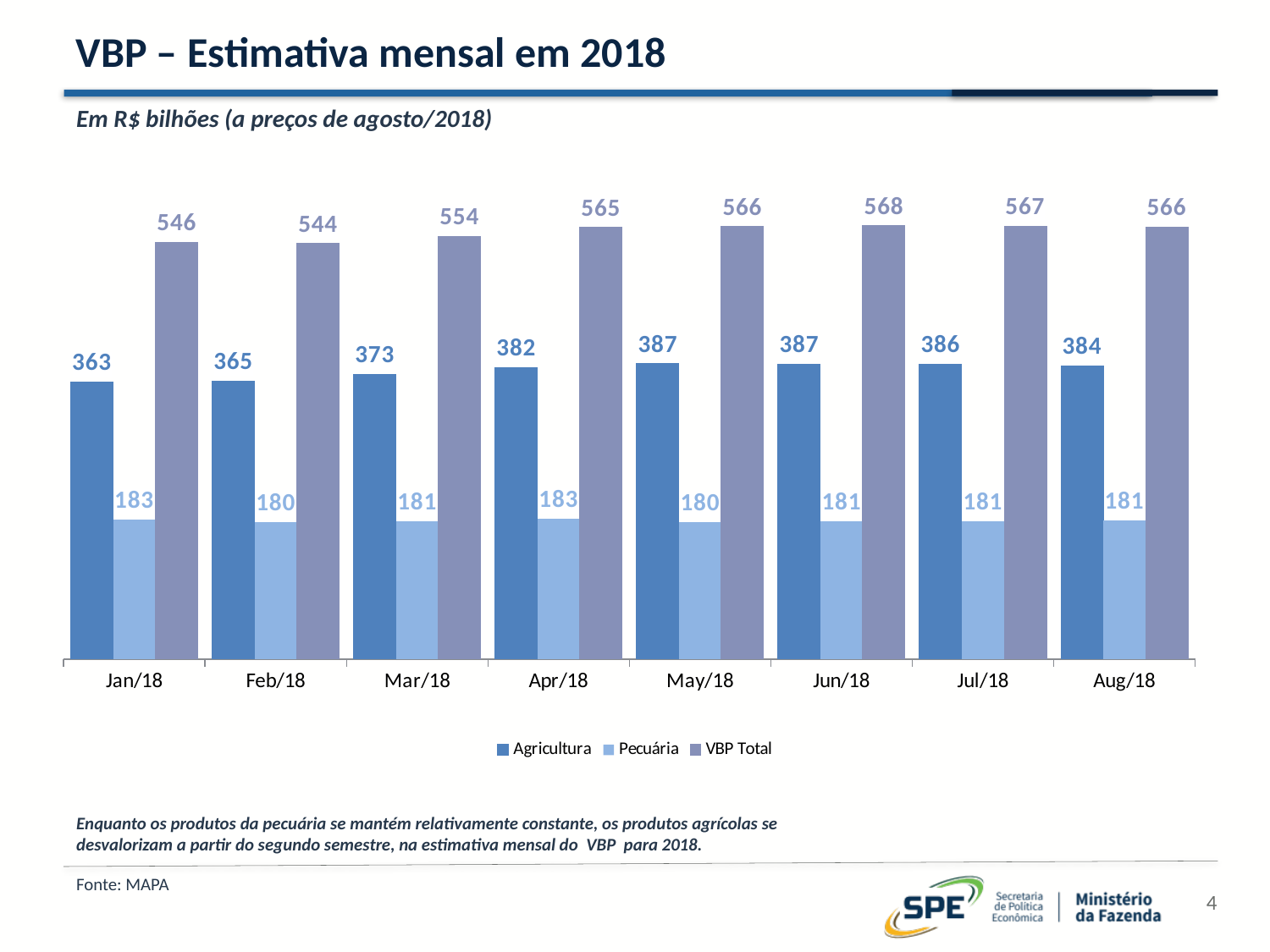
In which month is VBP Total highest? Jun/18 In which month is VBP Total lowest? Feb/18 What is the unit stated in the chart subtitle? R$ bilhões (a preços de agosto/2018) What kind of chart is shown on the slide? bar chart Which is larger, the Agricultura value for Mar/18 or for Aug/18? Aug/18 What is the Pecuária value for Feb/18? 180 What is the difference between the Agricultura values for May/18 and Jan/18? 24 How many months are shown on the x axis? 8 What is the VBP Total value for Jun/18? 568 What is the difference between the VBP Total values for Jun/18 and Jan/18? 22 What is the Agricultura value for Apr/18? 382 How many series does the legend list? 3